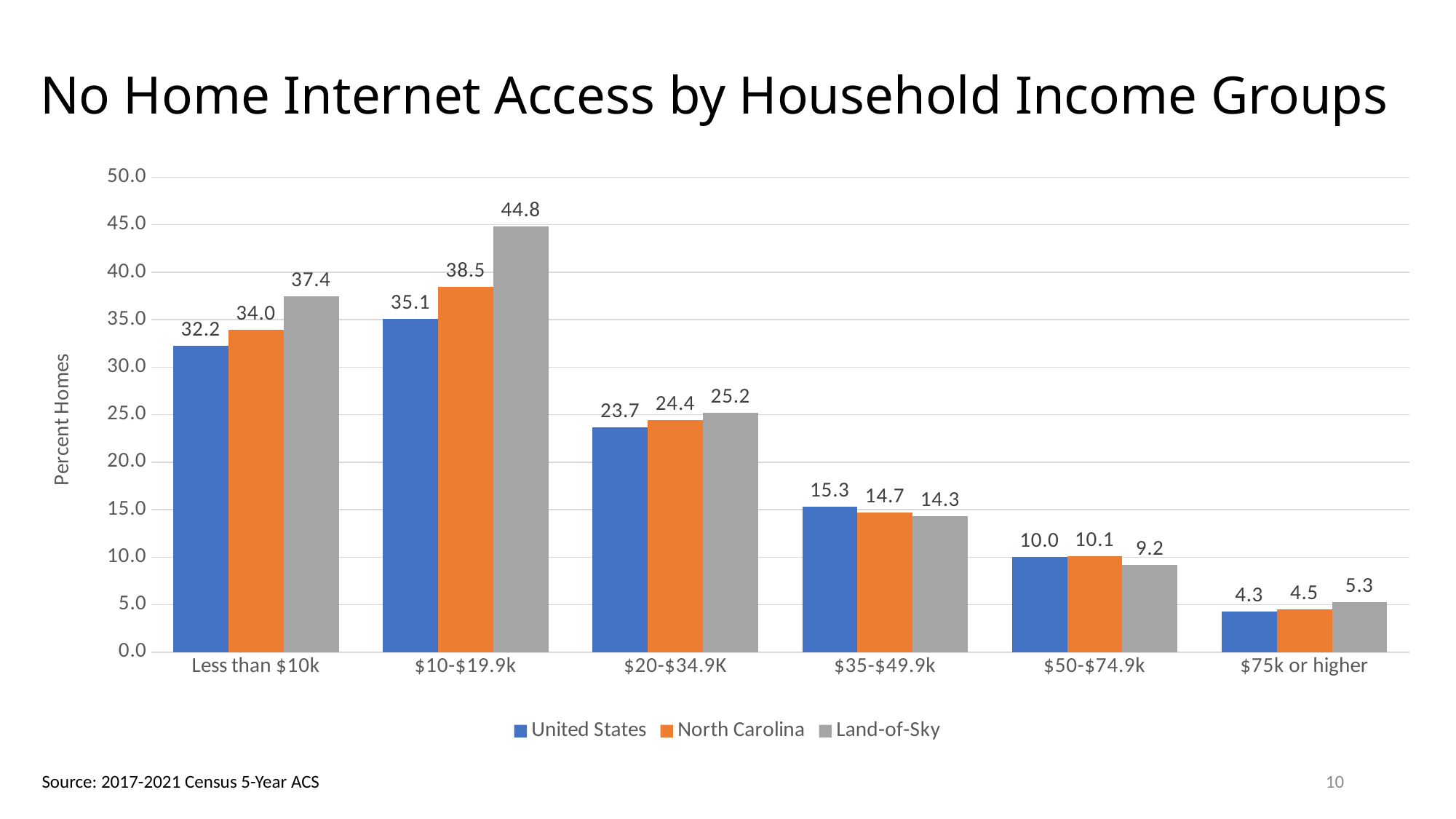
What is the North Carolina value for the $50-$74.9k income group? 10.1 What is the United States value for the Less than $10k income group? 32.2 How many series does the legend list? 3 Is the North Carolina value for the $20-$34.9K income group greater or less than 25.0? less For the $35-$49.9k income group, which is larger: the United States value or the Land-of-Sky value? United States How many income groups are shown on the x axis? 6 What is the difference between the Land-of-Sky and United States values for the $10-$19.9k income group? 9.7 What is the Land-of-Sky value for the $10-$19.9k income group? 44.8 What is the label of the y axis? Percent Homes Which income group has the highest Land-of-Sky value? $10-$19.9k What kind of chart is shown on the slide? bar chart Which income group has the lowest United States value? $75k or higher